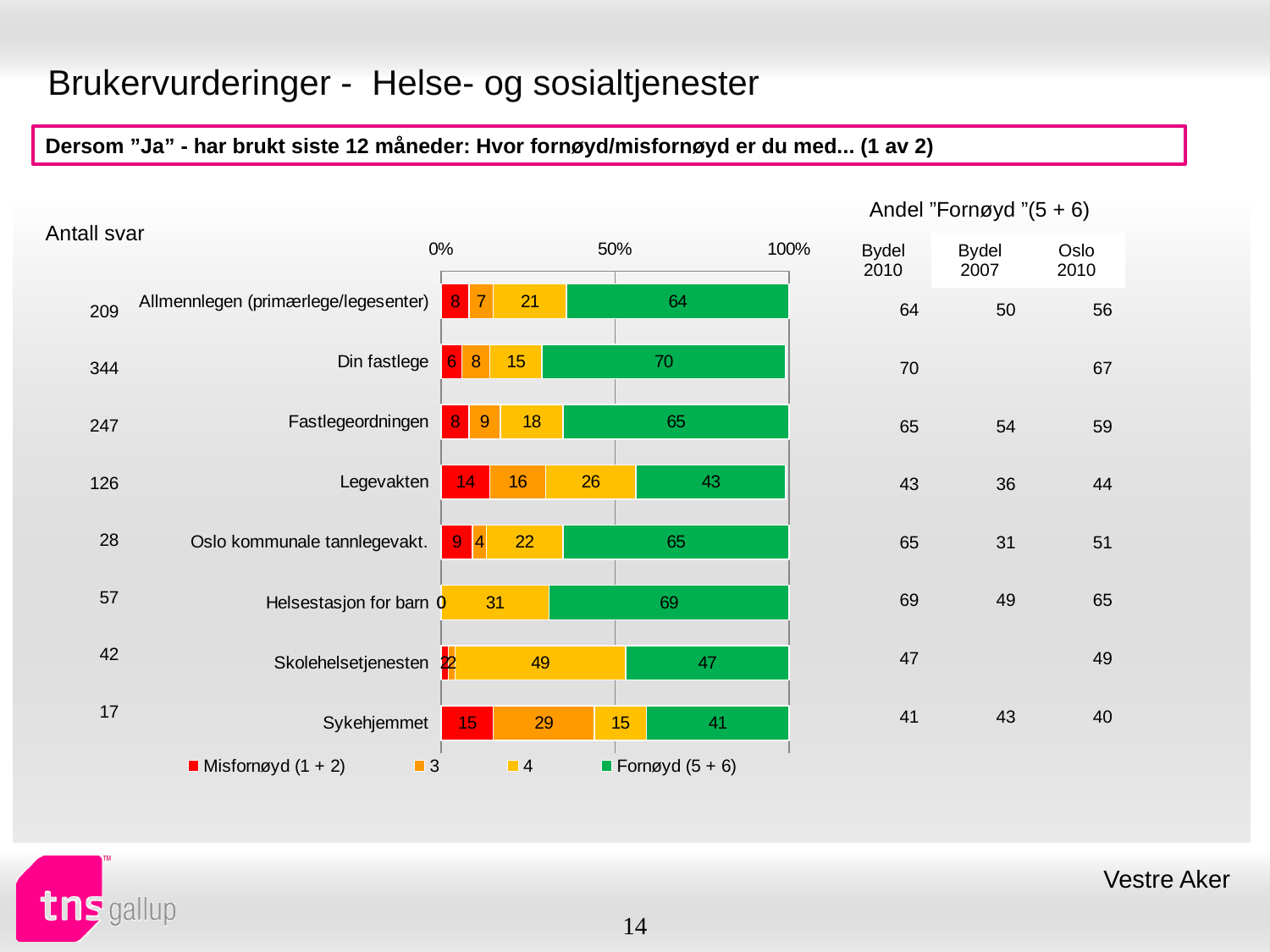
What kind of chart is shown on the slide? Stacked bar chart Which has a larger "Fornøyd (5 + 6)" value, "Fastlegeordningen" or "Sykehjemmet"? Fastlegeordningen Which category has the highest "Fornøyd (5 + 6)" value? Din fastlege What is the value of the "Misfornøyd (1 + 2)" segment for "Legevakten"? 14 What colour represents the "Fornøyd (5 + 6)" series in the chart? Green What is the difference between the "Fornøyd (5 + 6)" values for "Allmennlegen (primærlege/legesenter)" and "Legevakten"? 21 What is the value of the "Fornøyd (5 + 6)" segment for "Din fastlege"? 70 How many categories are shown in the bar chart? 8 What is the value of the "4" segment for "Skolehelsetjenesten"? 49 How many series does the legend list? 4 What is the total of the stacked bar for "Sykehjemmet"? 100 Which category has the lowest "Fornøyd (5 + 6)" value? Sykehjemmet